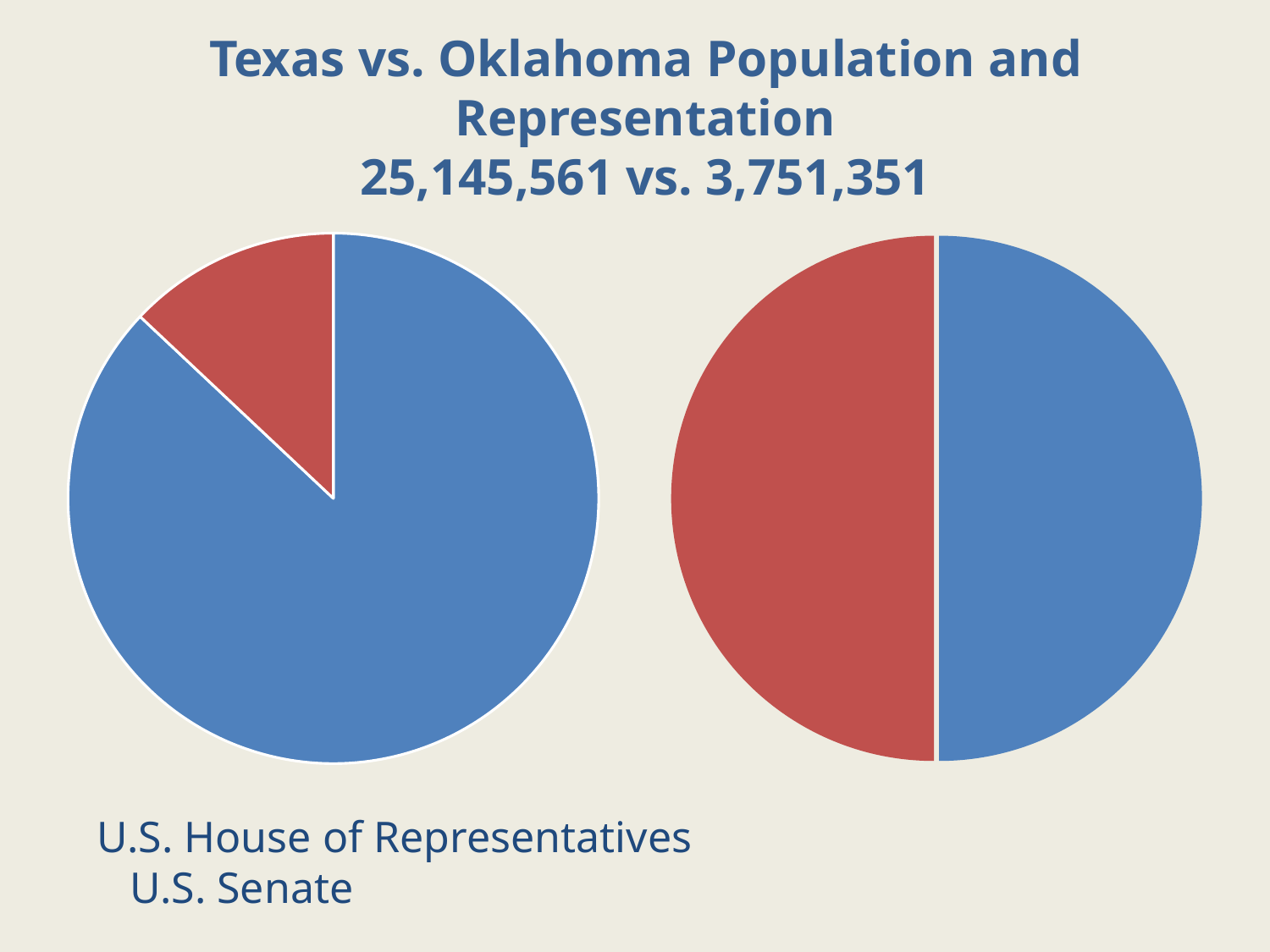
In the left pie chart, which slice is larger, the blue slice or the red slice? blue How many pie charts are shown on the slide? 2 What two colours are used for the slices in the pie charts? blue and red In the left pie chart, which colour slice is the largest? blue What kind of chart is the left chart on the slide? pie chart How many slices does the left pie chart have? 2 What kind of chart is the right chart on the slide? pie chart What is the title shown at the top of the slide above the charts? Texas vs. Oklahoma Population and Representation 25,145,561 vs. 3,751,351 How many slices does the right pie chart have? 2 In the left pie chart, which colour slice is the smallest? red